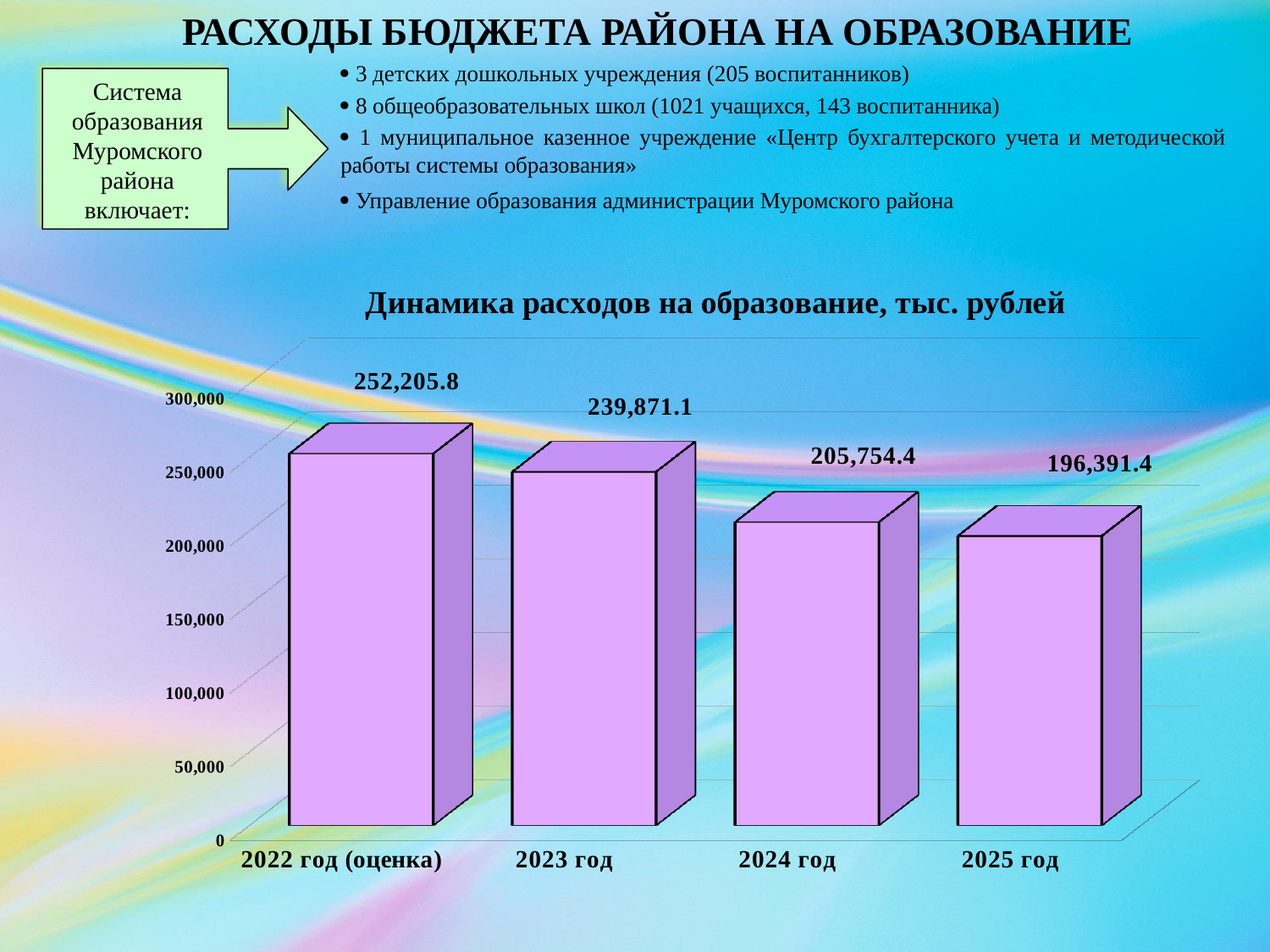
Which year has the highest value? 2022 год (оценка) What is the value for 2023 год? 239,871.1 What is the difference between the values for 2024 год and 2025 год? 9,363.0 Do the values rise or fall from 2022 год (оценка) to 2025 год? fall What is the value for 2022 год (оценка)? 252,205.8 Is the value for 2024 год greater or less than 200,000? greater What kind of chart is shown on the slide? bar chart Which is larger, the value for 2023 год or the value for 2024 год? 2023 год Which year has the lowest value? 2025 год How many years are shown on the x axis? 4 What is the value for 2025 год? 196,391.4 What is the difference between the values for 2022 год (оценка) and 2023 год? 12,334.7